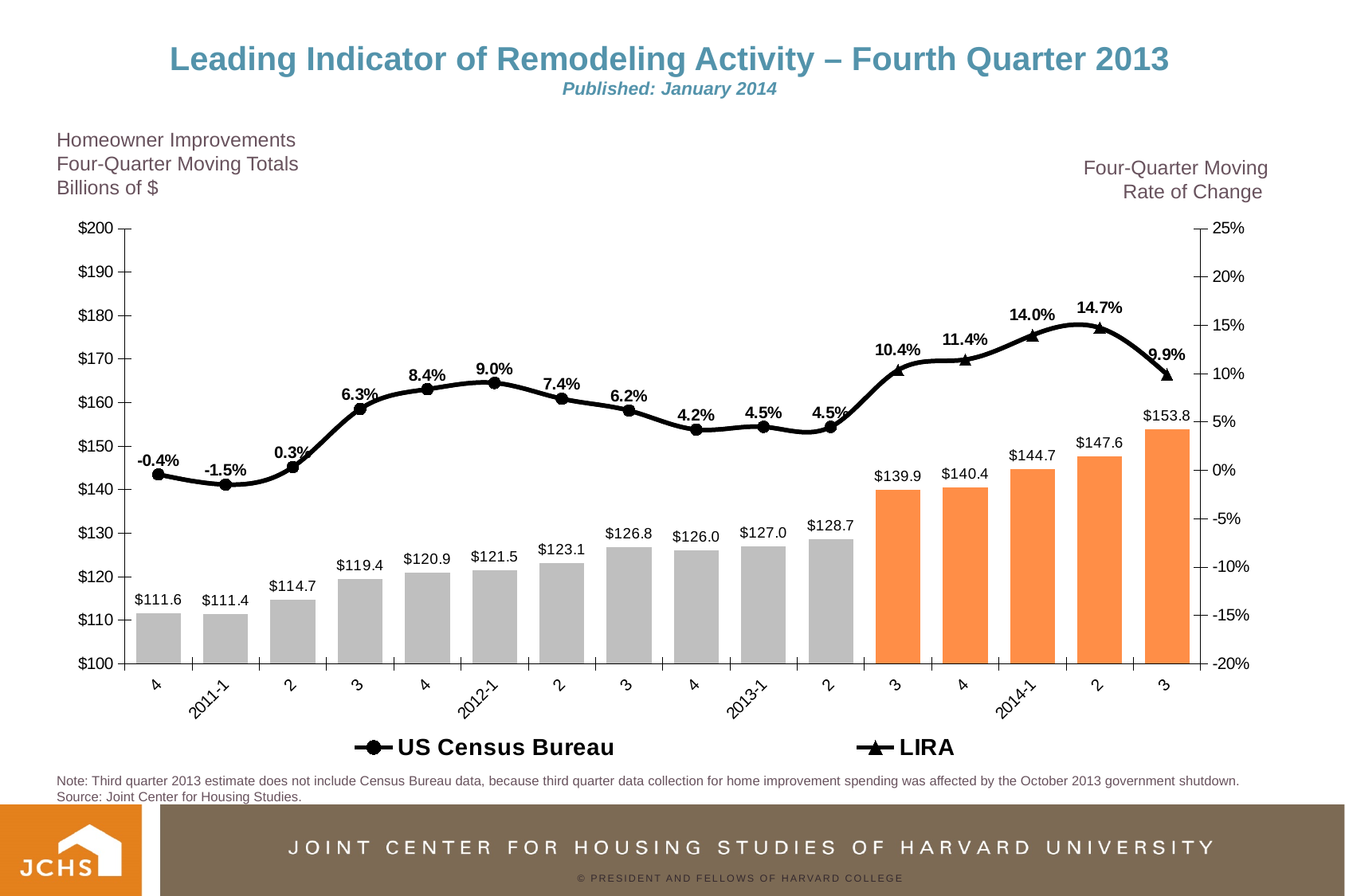
How many quarterly bars are plotted on the chart? 16 Which quarter has the highest four-quarter moving rate of change? 2014-2 (14.7%) Which quarter has the lowest four-quarter moving rate of change? 2011-1 (-1.5%) Do the four-quarter moving total bars generally rise or fall from left to right? Rise How many series does the legend list? 2 Which quarter has the highest four-quarter moving total bar? 2014-3 ($153.8) What is the four-quarter moving total for 2014-1? $144.7 What is the difference between the four-quarter moving totals for 2014-3 and 2014-2? $6.2 What is the four-quarter moving rate of change shown for 2012-1? 9.0% Which is larger, the four-quarter moving total for 2012-4 or for 2013-1? 2013-1 ($127.0) What are the two series named in the legend? US Census Bureau and LIRA What kind of chart is shown on the slide? Combined bar and line chart